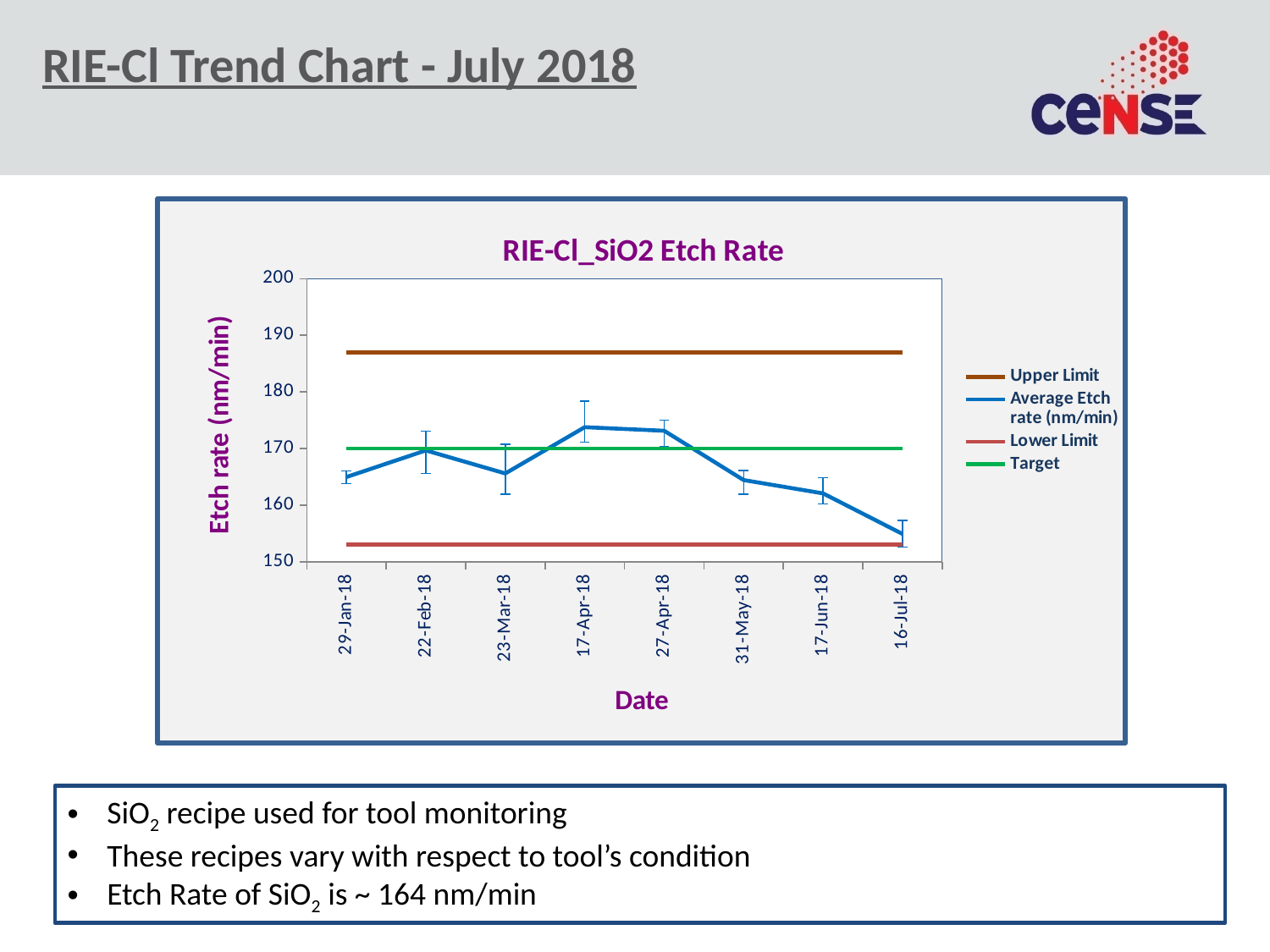
How many series does the chart legend list? 4 On which date is the Average Etch rate lowest? 16-Jul-18 What kind of chart is shown on the slide? line chart Which has the larger Average Etch rate, 22-Feb-18 or 16-Jul-18? 22-Feb-18 Is the Average Etch rate for 17-Apr-18 greater or less than 170? greater From 27-Apr-18 to 16-Jul-18, does the Average Etch rate rise or fall? fall What is the title of the chart? RIE-Cl_SiO2 Etch Rate Is the Average Etch rate for 29-Jan-18 greater or less than 170? less Is the Average Etch rate for 16-Jul-18 greater or less than 160? less How many dates are plotted along the x axis of the chart? 8 What is the value of the Target line in the chart? 170